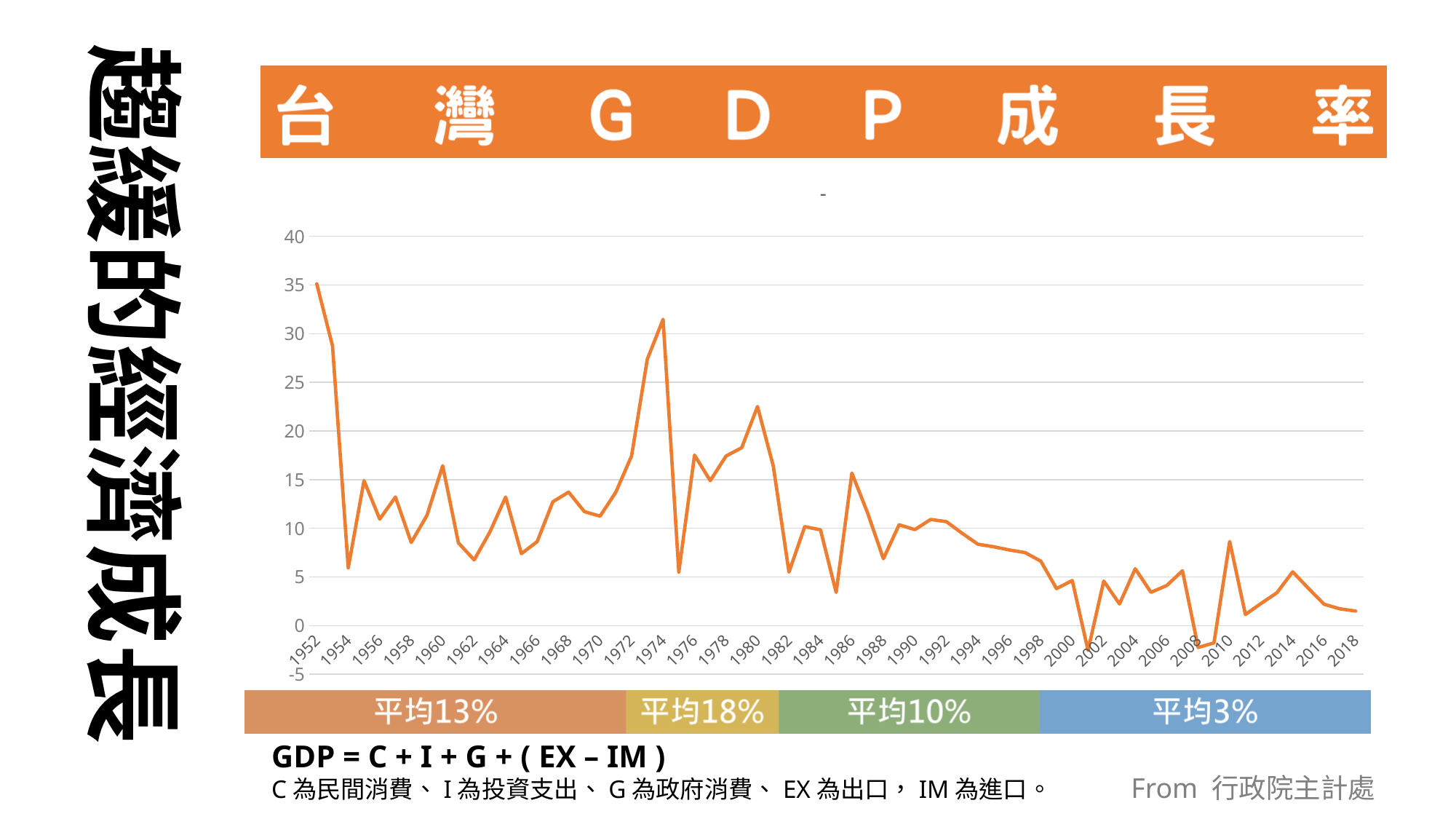
Which is larger, the value for 1952 or the value for 1974? 1952 Which is larger, the value for 1980 or the value for 1990? 1980 What is the title of the chart? 台灣GDP成長率 Is the value for 1980 greater or less than 20? greater Is the value for 2018 greater or less than 5? less Is the value for 1954 greater or less than 10? less What average growth rate is shown in the blue band below the chart for the most recent period? 平均3% What kind of chart is shown on the slide? line chart Which year has the highest GDP growth rate on the chart? 1952 Overall, do the values rise or fall from 1952 to 2018? fall